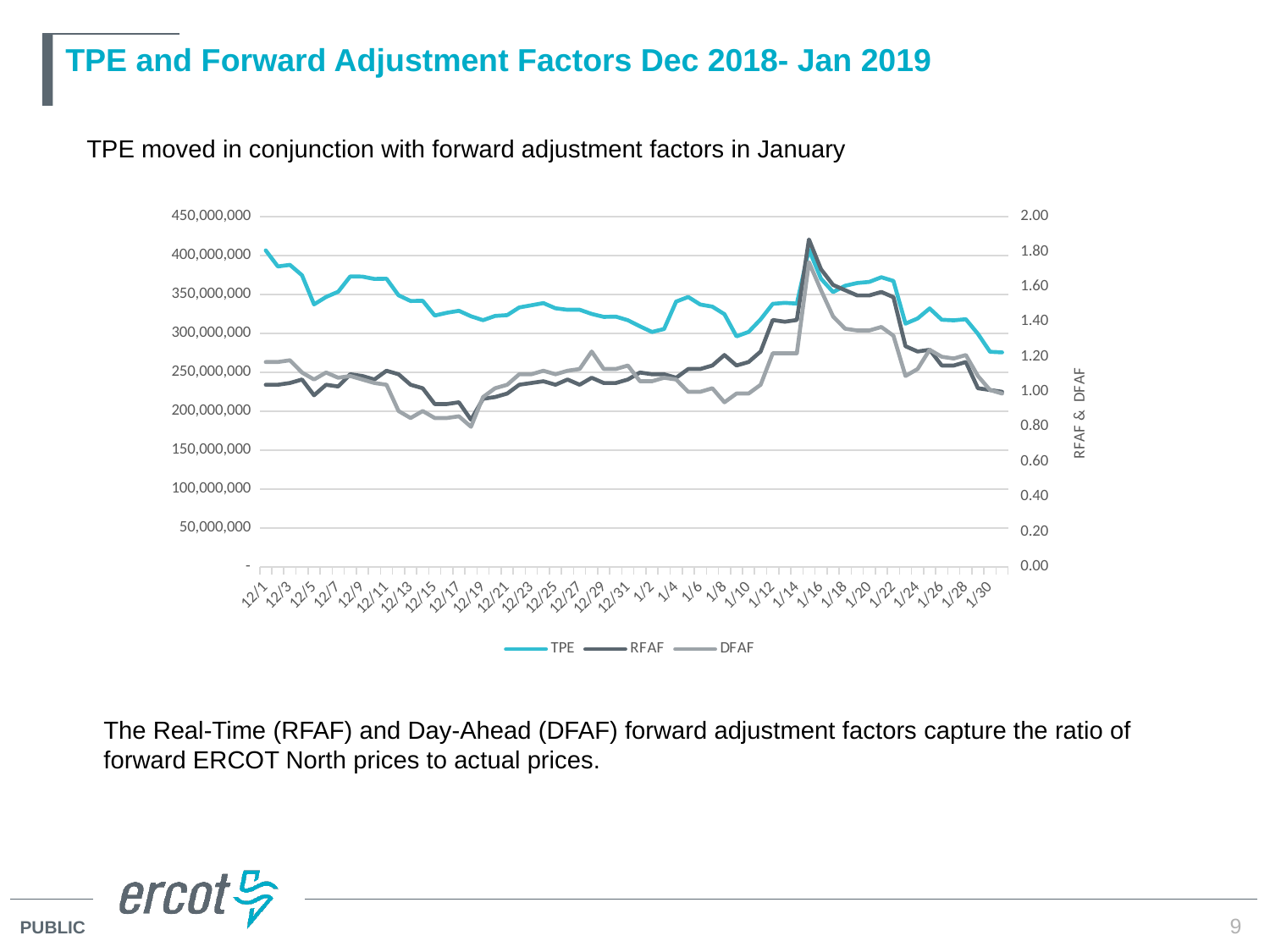
Is the DFAF value on 12/18 greater or less than 1.00? less Is the peak RFAF value in mid-January greater or less than 1.60? greater What is the title of the right-hand vertical axis? RFAF & DFAF Which is larger, the TPE value on 12/1 or the TPE value on 1/30? 12/1 Is the RFAF value on 12/1 greater or less than 1.20? less What kind of chart is shown on the slide? line chart Does the TPE line rise or fall from 1/22 to 1/30? fall Which series reaches the highest point on the right-hand axis in mid-January? RFAF How many series does the chart legend list? 3 What are the three series named in the chart legend? TPE, RFAF, DFAF